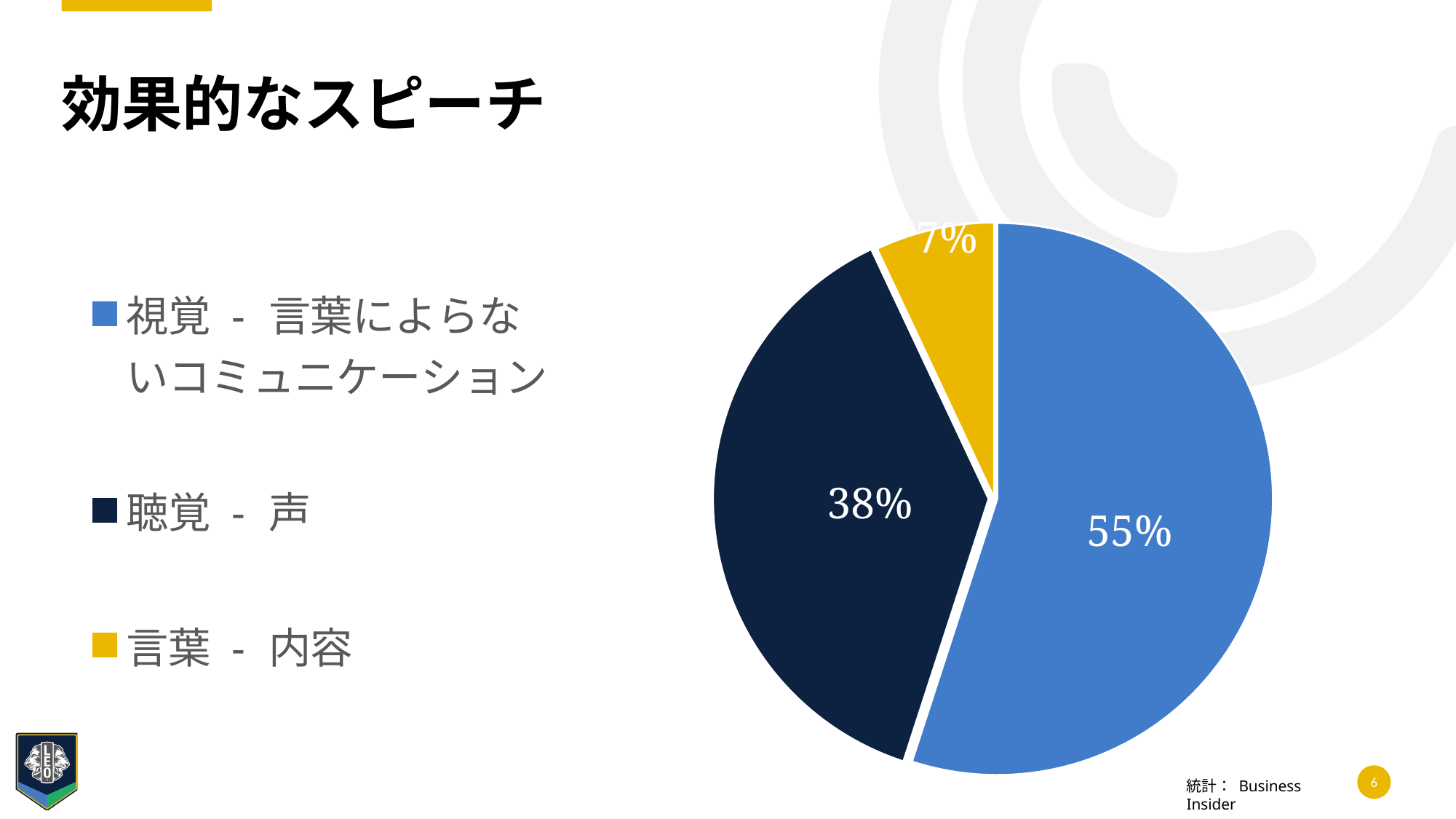
What is the difference in percentage points between 視覚 and 聴覚? 17 How many entries does the legend list? 3 What percentage is shown for 聴覚 - 声? 38% How many slices does the pie chart have? 3 What is the difference in percentage points between 聴覚 and 言葉? 31 What percentage is shown for 視覚 - 言葉によらないコミュニケーション? 55% Which category has the largest slice of the pie? 視覚 - 言葉によらないコミュニケーション Which category has the smallest slice of the pie? 言葉 - 内容 Which is larger, the slice for 聴覚 - 声 or the slice for 言葉 - 内容? 聴覚 - 声 What percentage is shown for 言葉 - 内容? 7% What colour is the slice for 言葉 - 内容? yellow What kind of chart is shown on the slide? pie chart